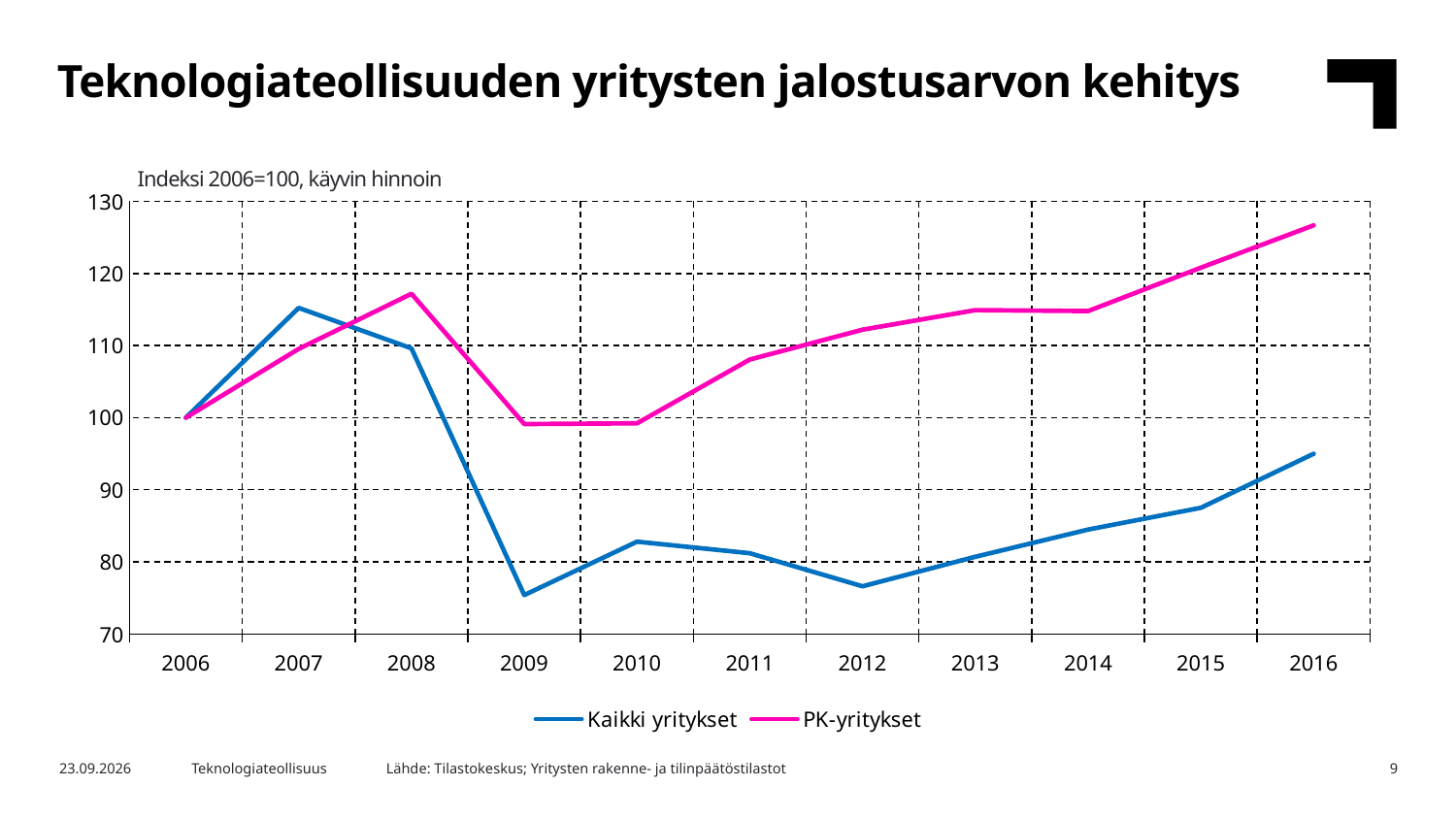
In which year is the value for PK-yritykset highest? 2016 What is the value for Kaikki yritykset in 2006? 100 How many years are plotted along the x axis? 11 In which year is the value for Kaikki yritykset lowest? 2009 Does the value for PK-yritykset rise or fall from 2010 to 2016? rise What kind of chart is shown on the slide? line chart Is the value for Kaikki yritykset in 2009 greater or less than 80? less Is the value for PK-yritykset in 2016 greater or less than 120? greater How many series does the legend list? 2 Which series has the larger value in 2016, Kaikki yritykset or PK-yritykset? PK-yritykset What is the value for PK-yritykset in 2006? 100 In which year is the value for Kaikki yritykset highest? 2007